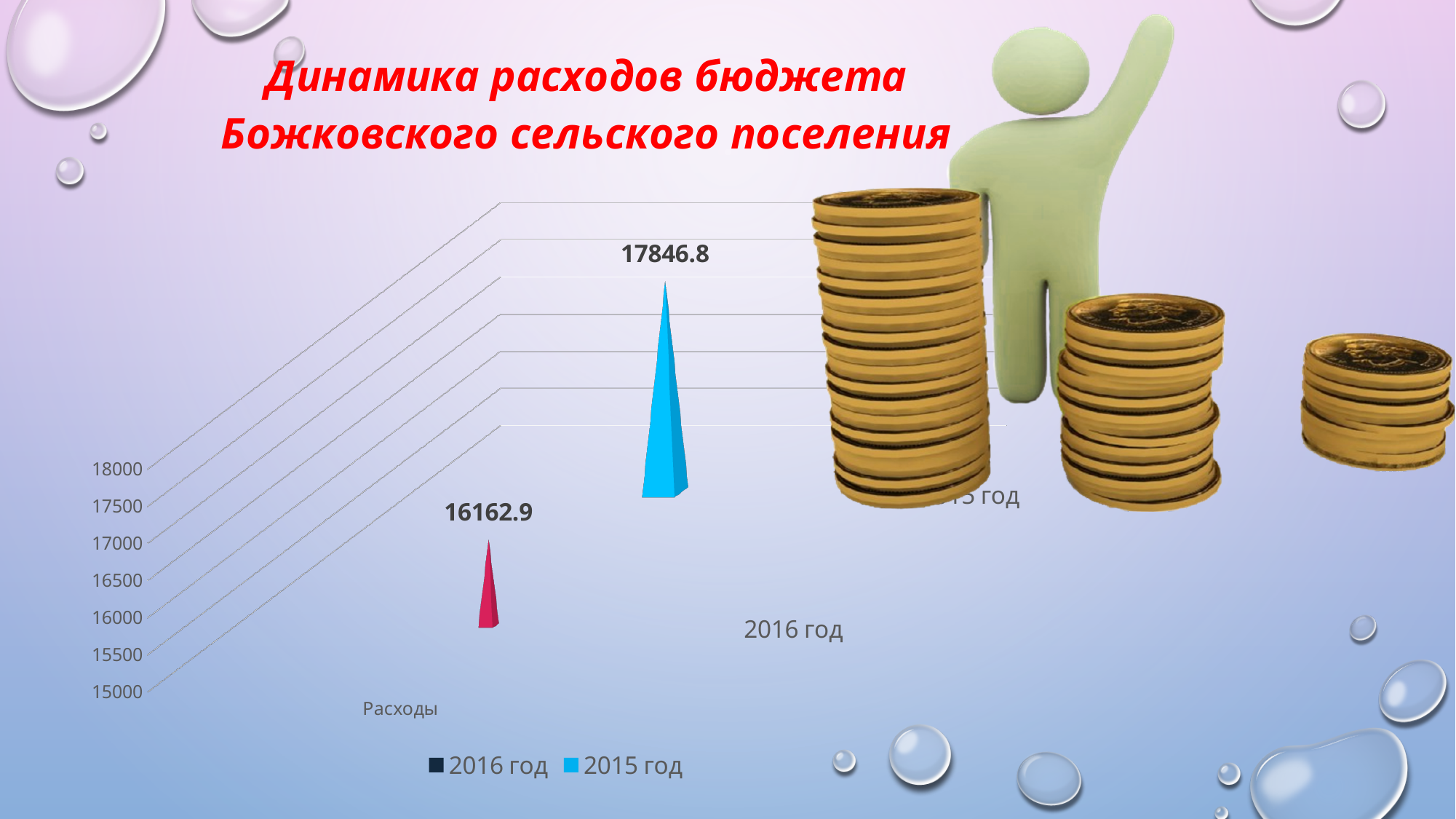
Did the expenditure value fall or rise from 2015 год to 2016 год? fall What is the title of the slide containing the chart? Динамика расходов бюджета Божковского сельского поселения How many series does the legend list? 2 What is the value for 2015 год in the chart? 17846.8 Which series has the lowest value in the chart? 2016 год Which series has the higher value, 2016 год or 2015 год? 2015 год Is the value for 2016 год greater or less than 16000? greater Is the value for 2015 год greater or less than 17500? greater Which series has the highest value in the chart? 2015 год What is the value for 2016 год in the chart? 16162.9 What is the difference between the 2015 год value and the 2016 год value? 1683.9 What is the category label shown on the x axis of the chart? Расходы